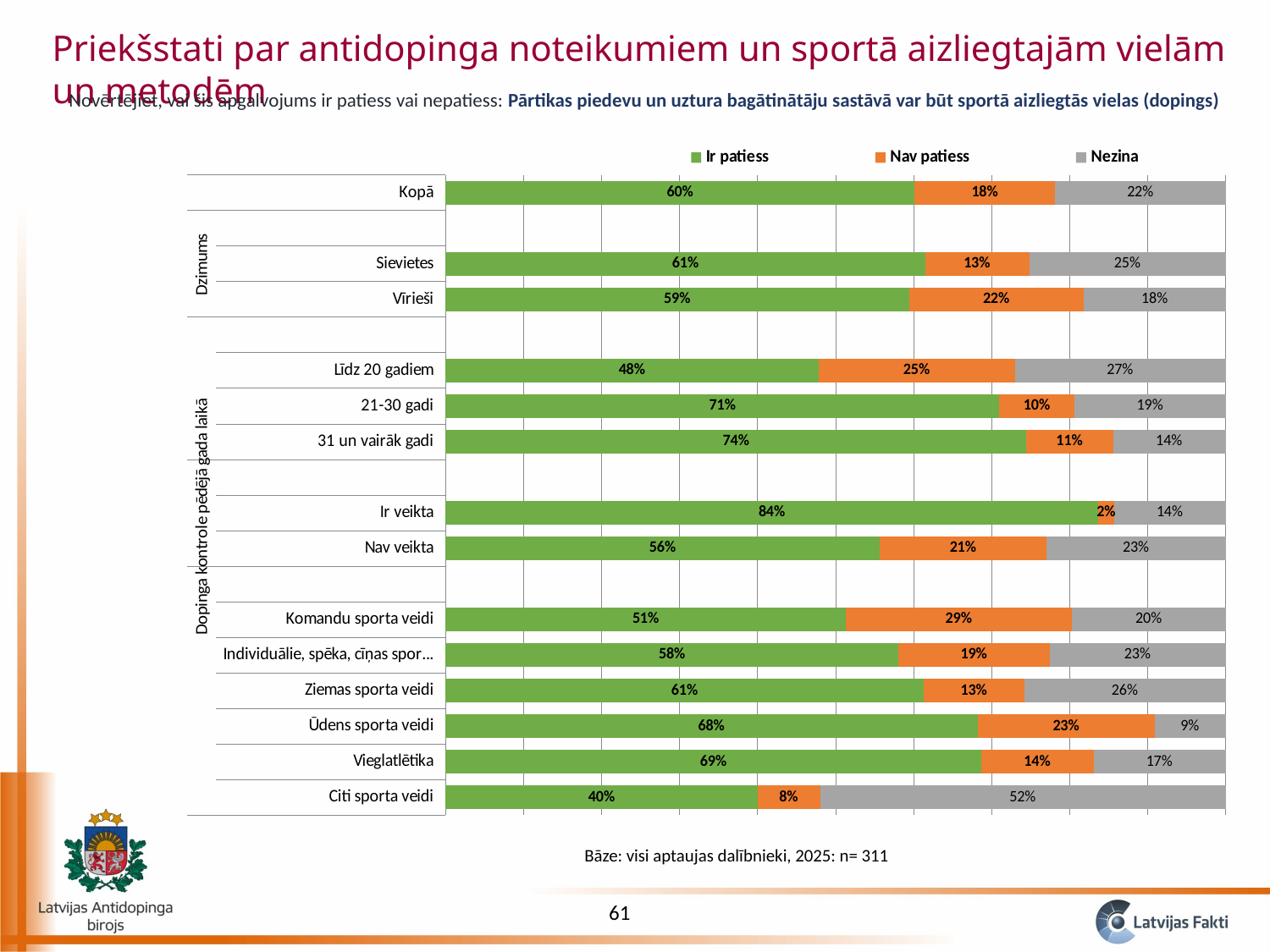
What is the "Nezina" value for "Citi sporta veidi"? 52% Which has a larger "Nav patiess" value, "Līdz 20 gadiem" or "21-30 gadi"? Līdz 20 gadiem What percentage of respondents in the "Kopā" category answered "Ir patiess"? 60% Which category has the lowest "Ir patiess" value? Citi sporta veidi How many series does the legend list? 3 What kind of chart is shown on the slide? Stacked bar chart What is the difference between the "Ir patiess" values for "Sievietes" and "Vīrieši"? 2% What is the "Nav patiess" value for "Komandu sporta veidi"? 29% How many categories are plotted in the chart? 14 Which series is shown in orange in the legend? Nav patiess What is the "Nezina" value for "Ūdens sporta veidi"? 9% Which category has the highest "Ir patiess" value? Ir veikta